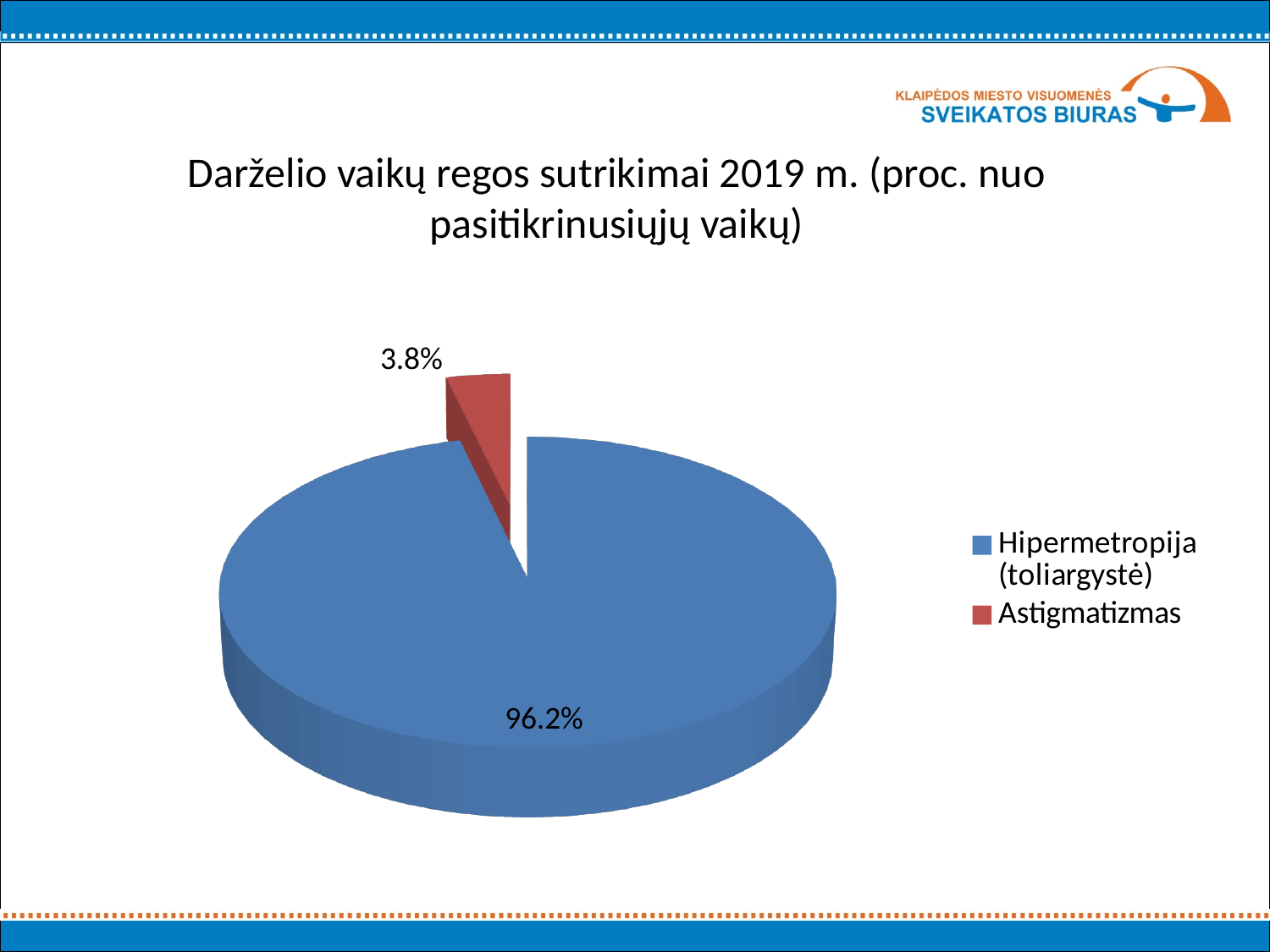
What share of the pie does Hipermetropija (toliarygstė) have? 96.2% Which category has the smallest share of the pie? Astigmatizmas How many categories does the pie chart have? 2 What is the difference in percentage points between Hipermetropija (toliarygstė) and Astigmatizmas? 92.4 What is the title of the chart? Darželio vaikų regos sutrikimai 2019 m. (proc. nuo pasitikrinusiųjų vaikų) Which category has the largest share of the pie? Hipermetropija (toliargystė) Which is larger, the share for Hipermetropija (toliarygstė) or for Astigmatizmas? Hipermetropija (toliargystė) What colour is the slice for Astigmatizmas? red What kind of chart is shown on the slide? pie chart How many entries does the legend list? 2 What share of the pie does Astigmatizmas have? 3.8%